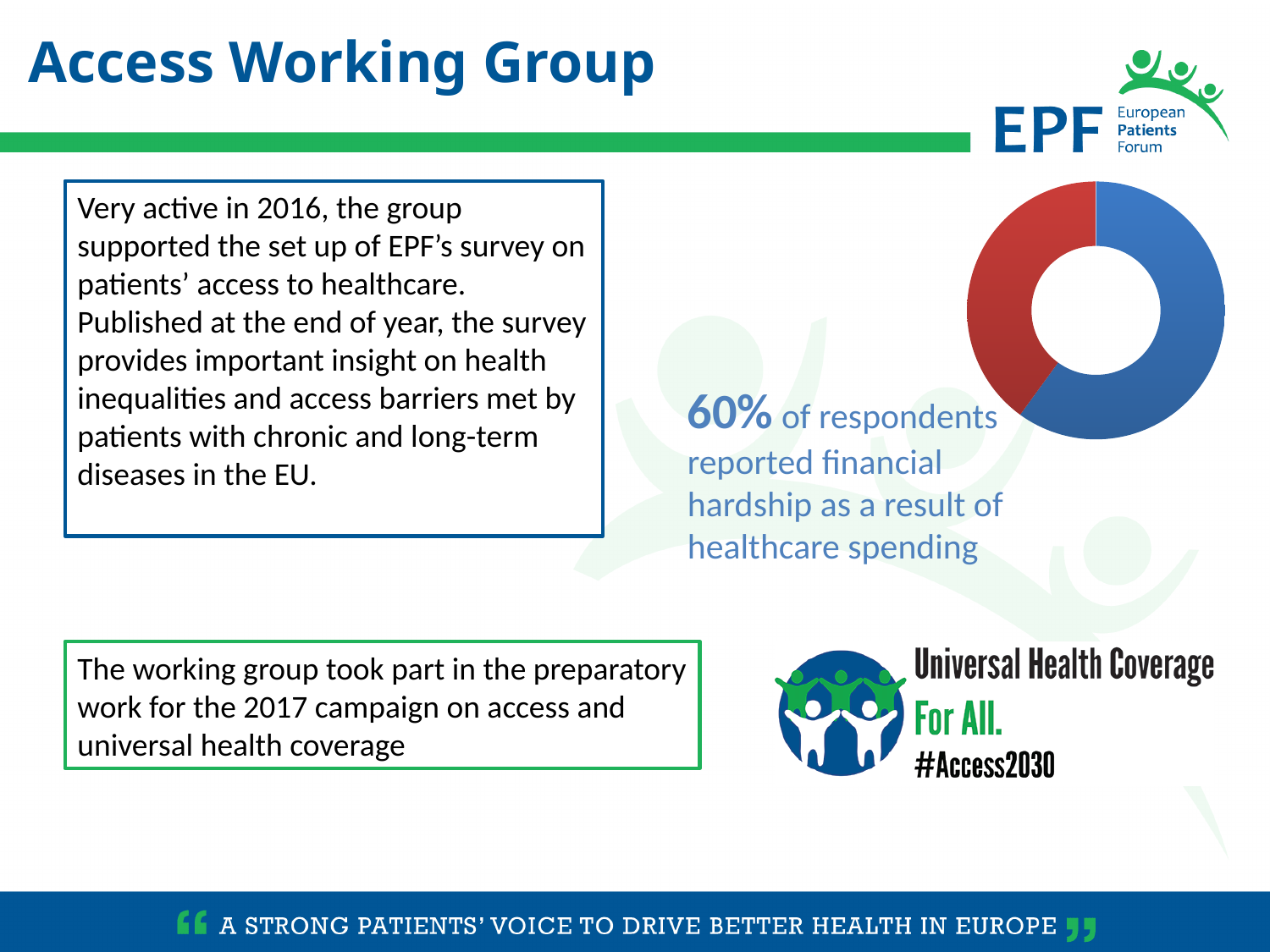
Is the blue slice of the doughnut chart greater or less than 50% of the whole? greater Which slice of the doughnut chart is larger, the blue one or the red one? Blue What share of respondents does the blue slice of the doughnut chart represent? 60% What share of the doughnut chart does the red slice represent? 40% What two colours are used for the slices of the doughnut chart? Blue and red How many slices does the doughnut chart have? 2 Does the doughnut chart display a legend? No Is the red slice of the doughnut chart greater or less than 50% of the whole? less What kind of chart is shown on the slide? Doughnut chart What percentage of respondents reported financial hardship as a result of healthcare spending, according to the chart? 60%